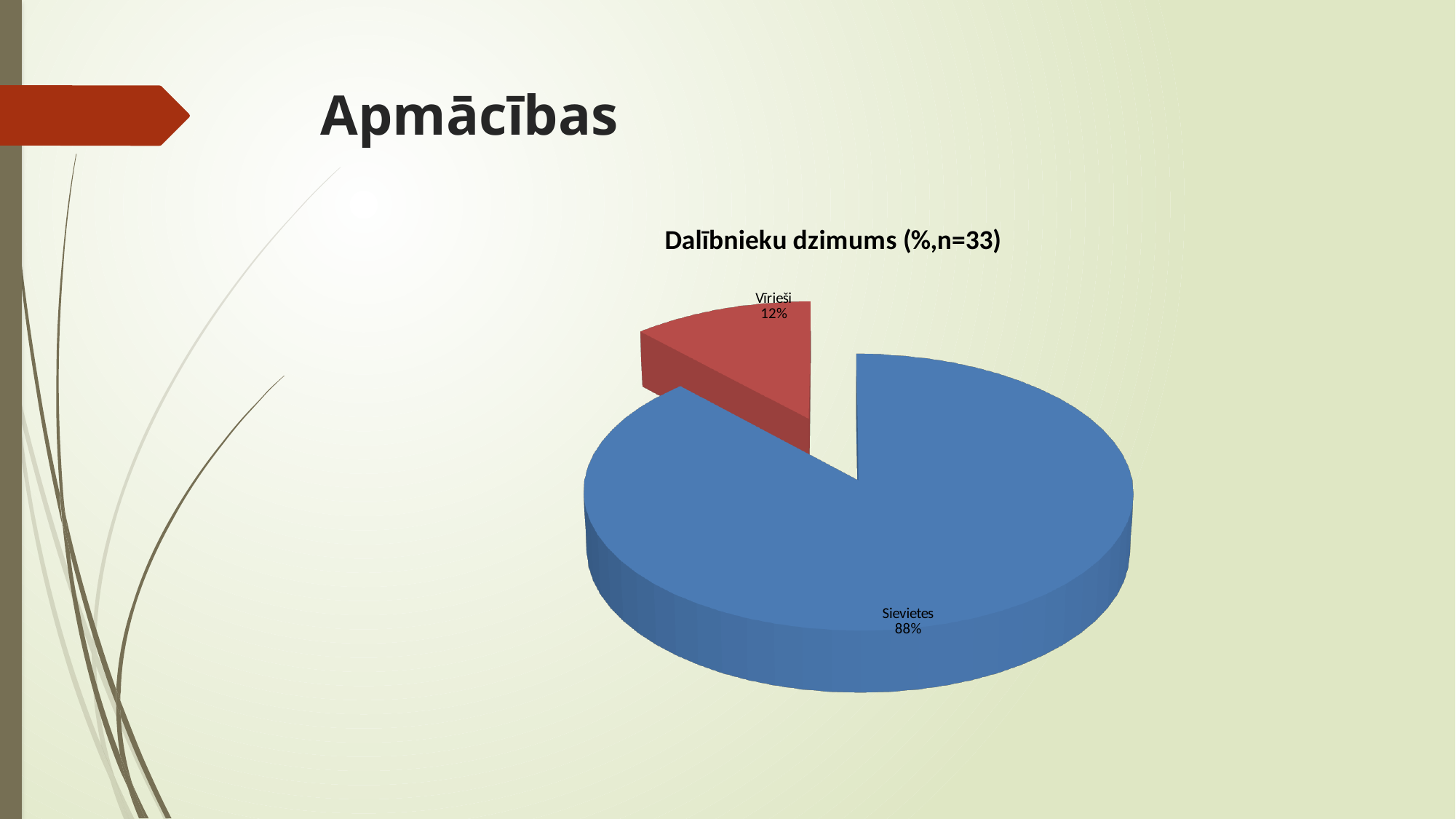
Which is larger, the share for Sievietes or the share for Vīrieši? Sievietes What is the title of the chart? Dalībnieku dzimums (%,n=33) How many slices does the pie chart have? 2 What kind of chart is shown on the slide? pie chart What share of the pie is Sievietes? 88% What share of the pie is Vīrieši? 12% Which category has the largest slice of the pie? Sievietes What is the total of the two slices shown? 100% Which category has the smallest slice of the pie? Vīrieši What is the difference in percentage points between Sievietes and Vīrieši? 76 What colour is the Vīrieši slice? red